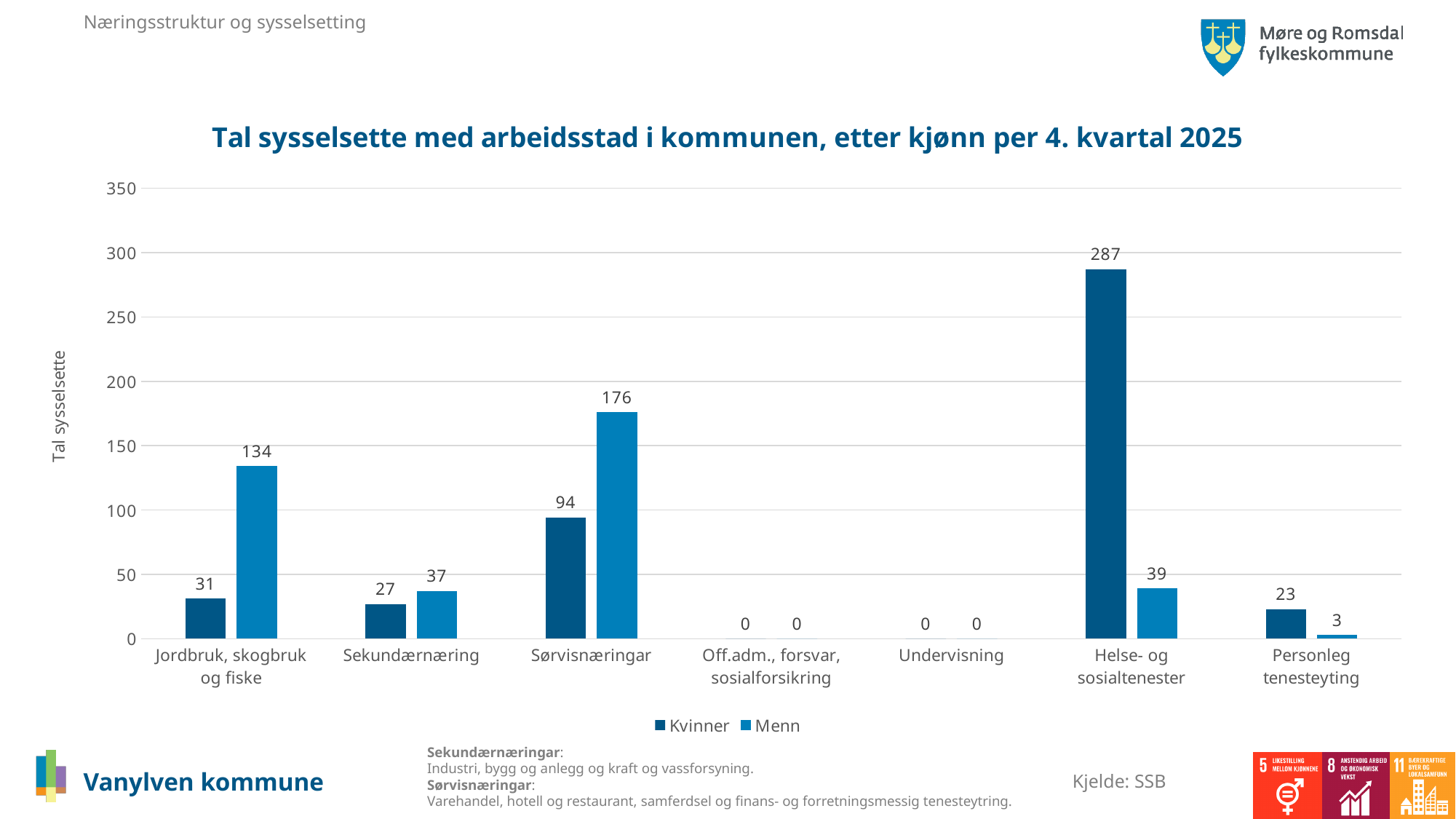
Which category has the highest value for Menn? Sørvisnæringar What kind of chart is shown? Bar chart How many series does the legend list? 2 What is the difference between Kvinner and Menn in Helse- og sosialtenester? 248 What is the value for Menn in Personleg tenesteyting? 3 How many categories are shown on the x axis? 7 Which category has the highest value for Kvinner? Helse- og sosialtenester What is the difference between Menn and Kvinner in Sørvisnæringar? 82 What is the value for Kvinner in Sørvisnæringar? 94 What is the value for Menn in Jordbruk, skogbruk og fiske? 134 What is the value for Kvinner in Helse- og sosialtenester? 287 Which is larger in Sekundærnæring, Kvinner or Menn? Menn